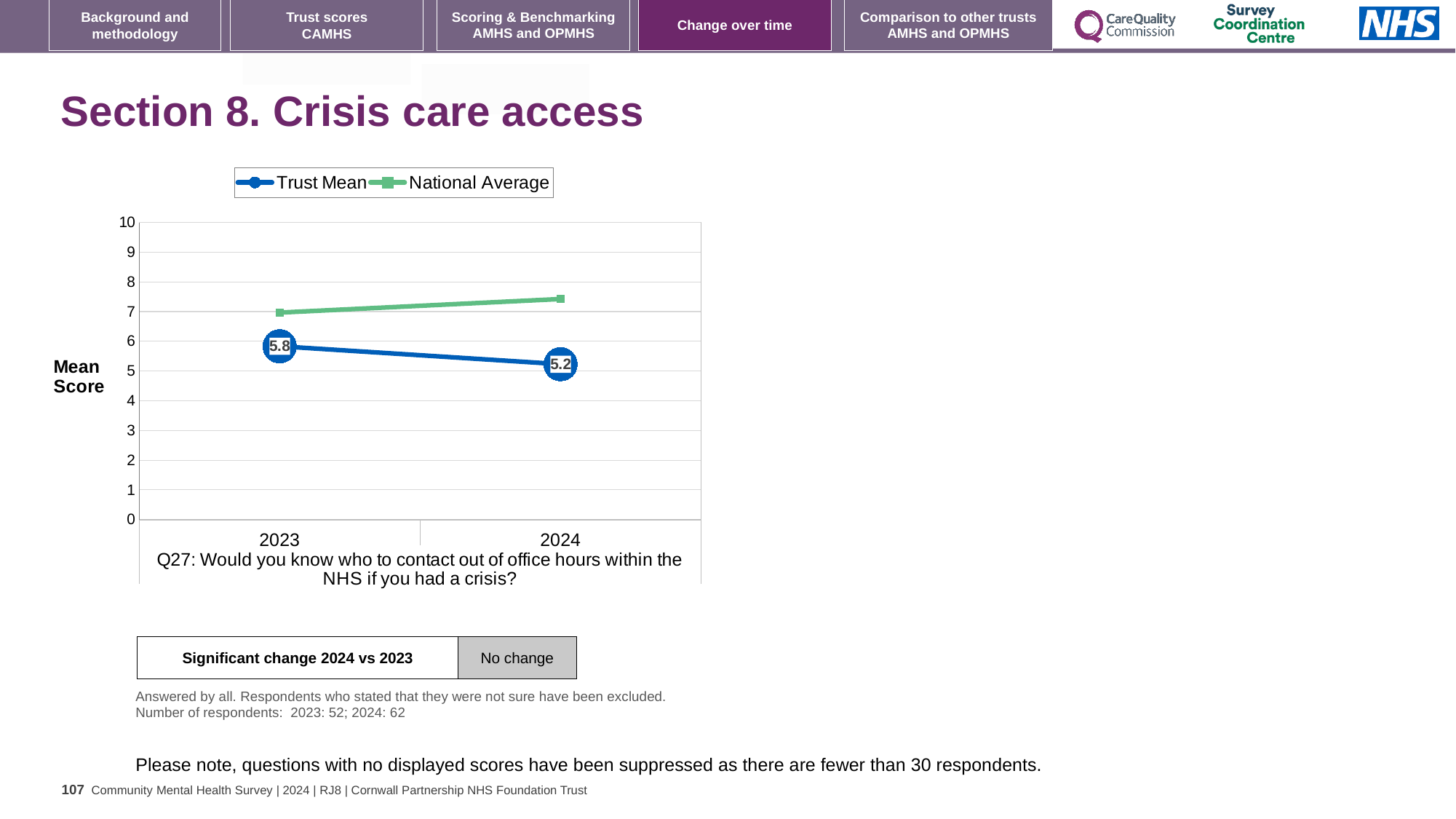
In 2024, which is higher: the Trust Mean or the National Average? National Average Is the National Average for 2024 greater or less than 7? greater What kind of chart is shown on the slide? line chart Does the Trust Mean rise or fall from 2023 to 2024? fall What is the Trust Mean score for 2024? 5.2 What is the Trust Mean score for 2023? 5.8 How many series does the legend list? 2 Which year has the higher Trust Mean score? 2023 Does the National Average rise or fall from 2023 to 2024? rise By how much did the Trust Mean score change from 2023 to 2024? 0.6 What is the label of the y axis? Mean Score Which year has the lower Trust Mean score? 2024